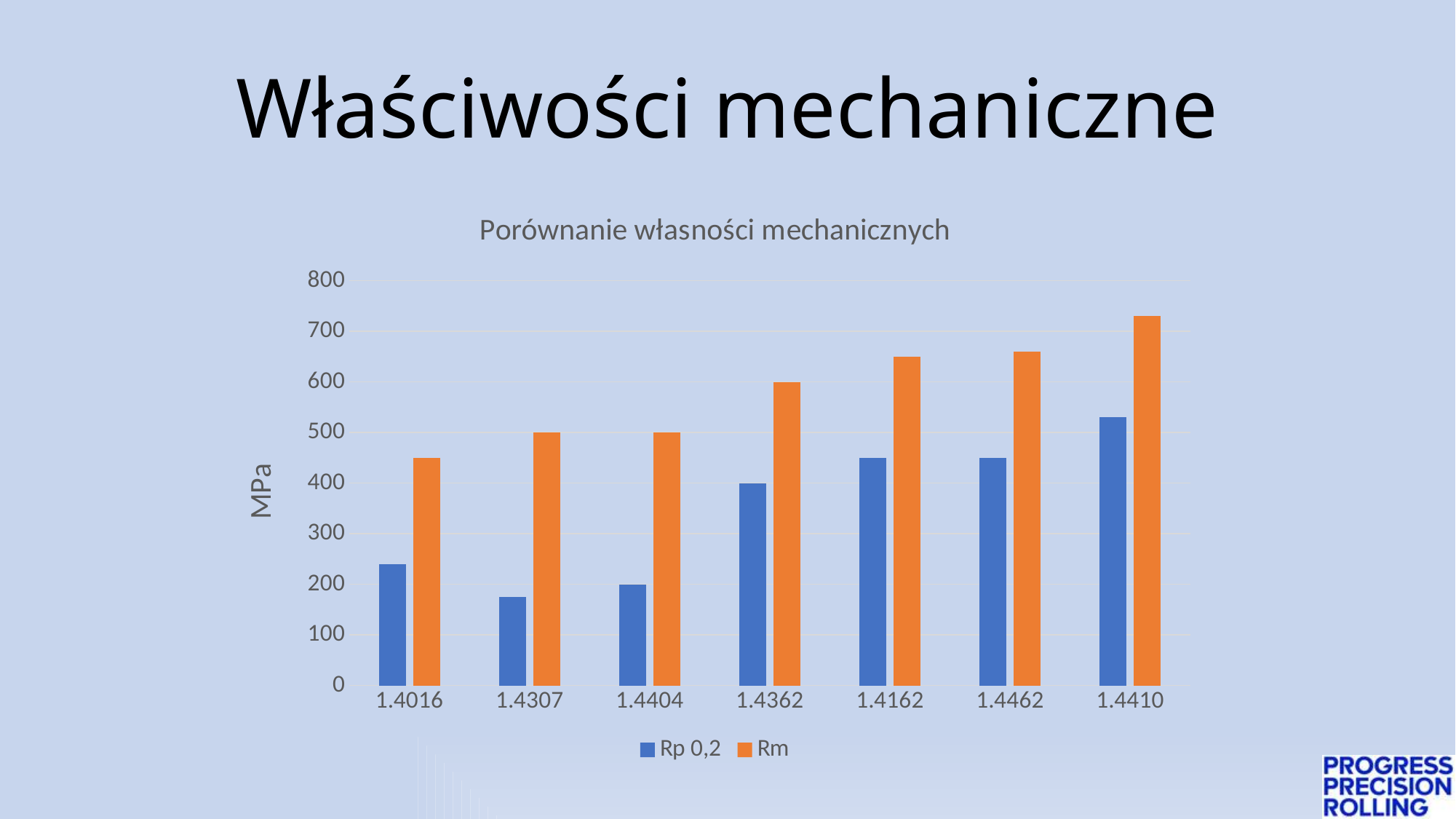
What is the Rm value for 1.4362? 600 For 1.4162, which is larger: Rp 0,2 or Rm? Rm How many steel grades (categories) are shown on the x axis? 7 How many series does the legend list? 2 Which steel grade has the highest Rm value? 1.4410 What kind of chart is shown on the slide? bar chart Do the Rm values generally rise or fall from left to right along the x axis? rise Is the Rm value for 1.4410 greater or less than 700? greater Is the Rp 0,2 value for 1.4016 greater or less than 300? less What is the Rm value for 1.4307? 500 What is the Rp 0,2 value for 1.4362? 400 Which steel grade has the lowest Rp 0,2 value? 1.4307